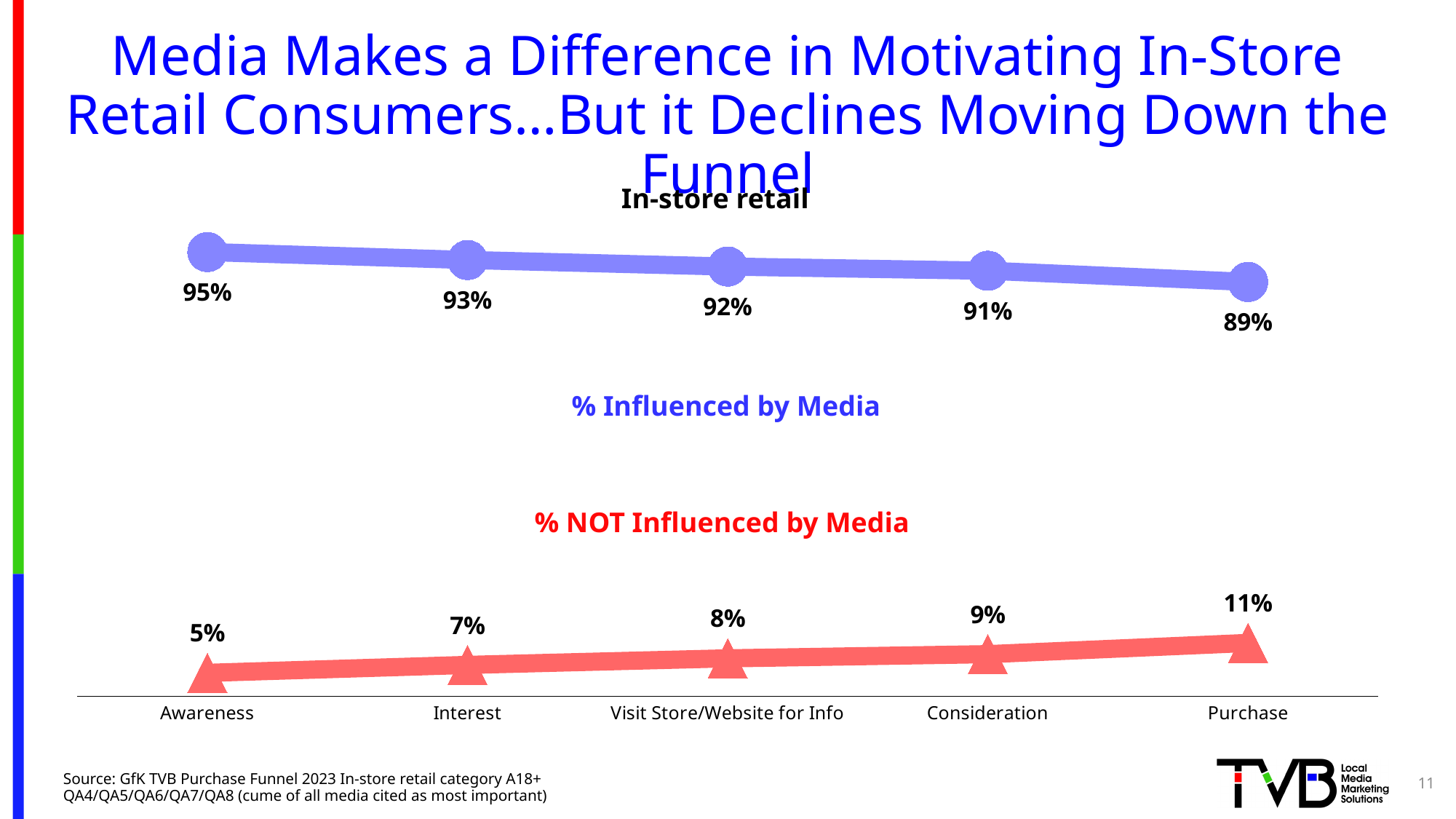
What is the % NOT Influenced by Media value at Visit Store/Website for Info? 8% At which funnel stage is the % NOT Influenced by Media highest? Purchase What is the % NOT Influenced by Media value at the Purchase stage? 11% Which is larger: the % NOT Influenced by Media at Interest or at Consideration? Consideration How many data series are plotted on the chart? 2 Does the % Influenced by Media rise or fall moving from Awareness to Purchase? Fall What is the % Influenced by Media value at the Awareness stage? 95% At which funnel stage is the % Influenced by Media lowest? Purchase How many funnel stages are shown on the x axis? 5 What is the difference between the % Influenced by Media at Awareness and at Purchase? 6 percentage points What kind of chart is shown on the slide? Line chart What is the % Influenced by Media value at the Consideration stage? 91%